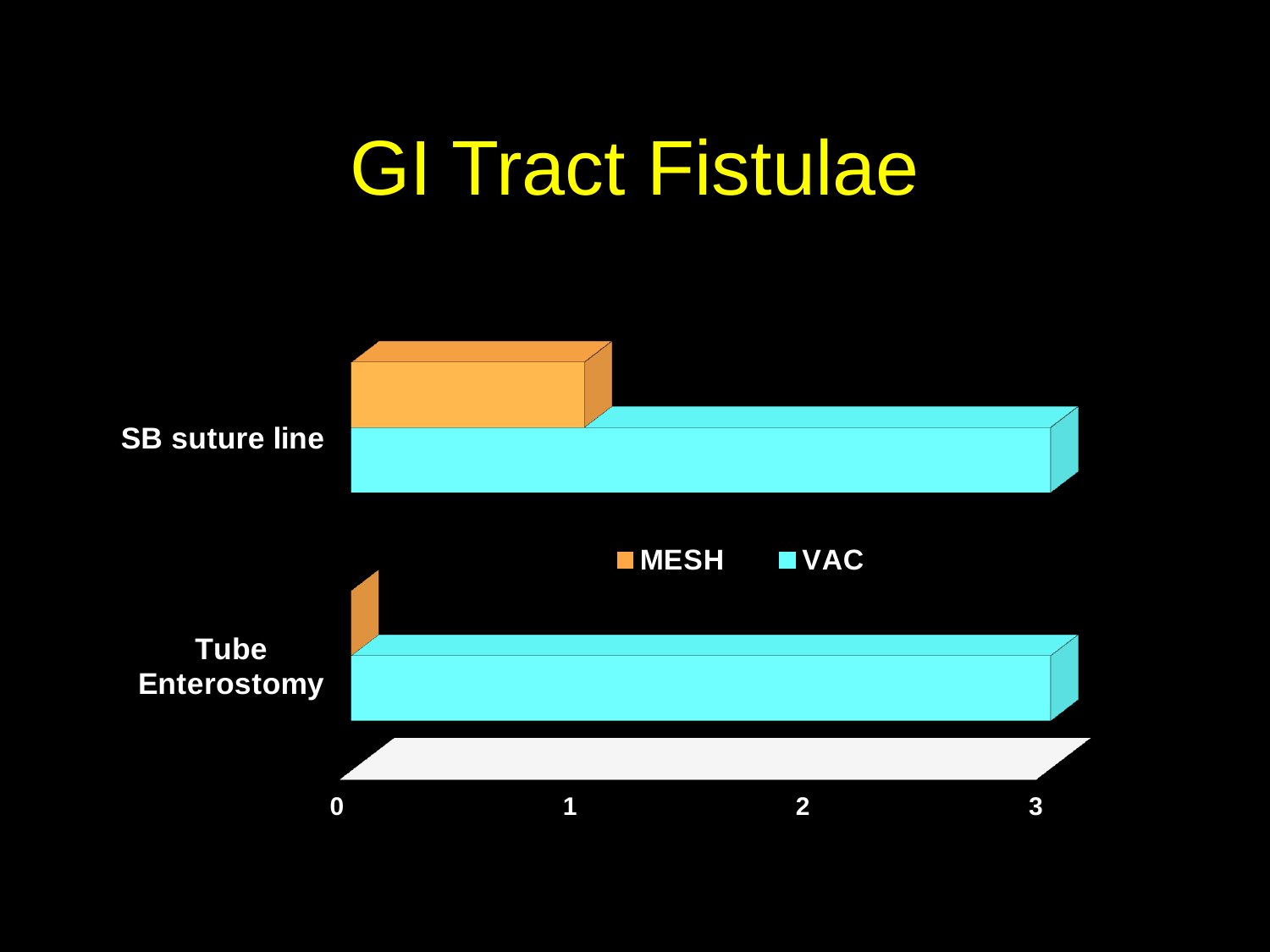
What is the VAC value for SB suture line? 3 What is the VAC value for Tube Enterostomy? 3 Which series is shown in orange? MESH How many categories are shown on the chart? 2 Is the VAC value for Tube Enterostomy greater or less than 2? greater What kind of chart is shown on the slide? bar chart Which category has the lowest MESH value? Tube Enterostomy What is the title of the chart? GI Tract Fistulae What is the MESH value for Tube Enterostomy? 0 Which is larger for SB suture line, the MESH value or the VAC value? VAC What is the MESH value for SB suture line? 1 How many series does the legend list? 2